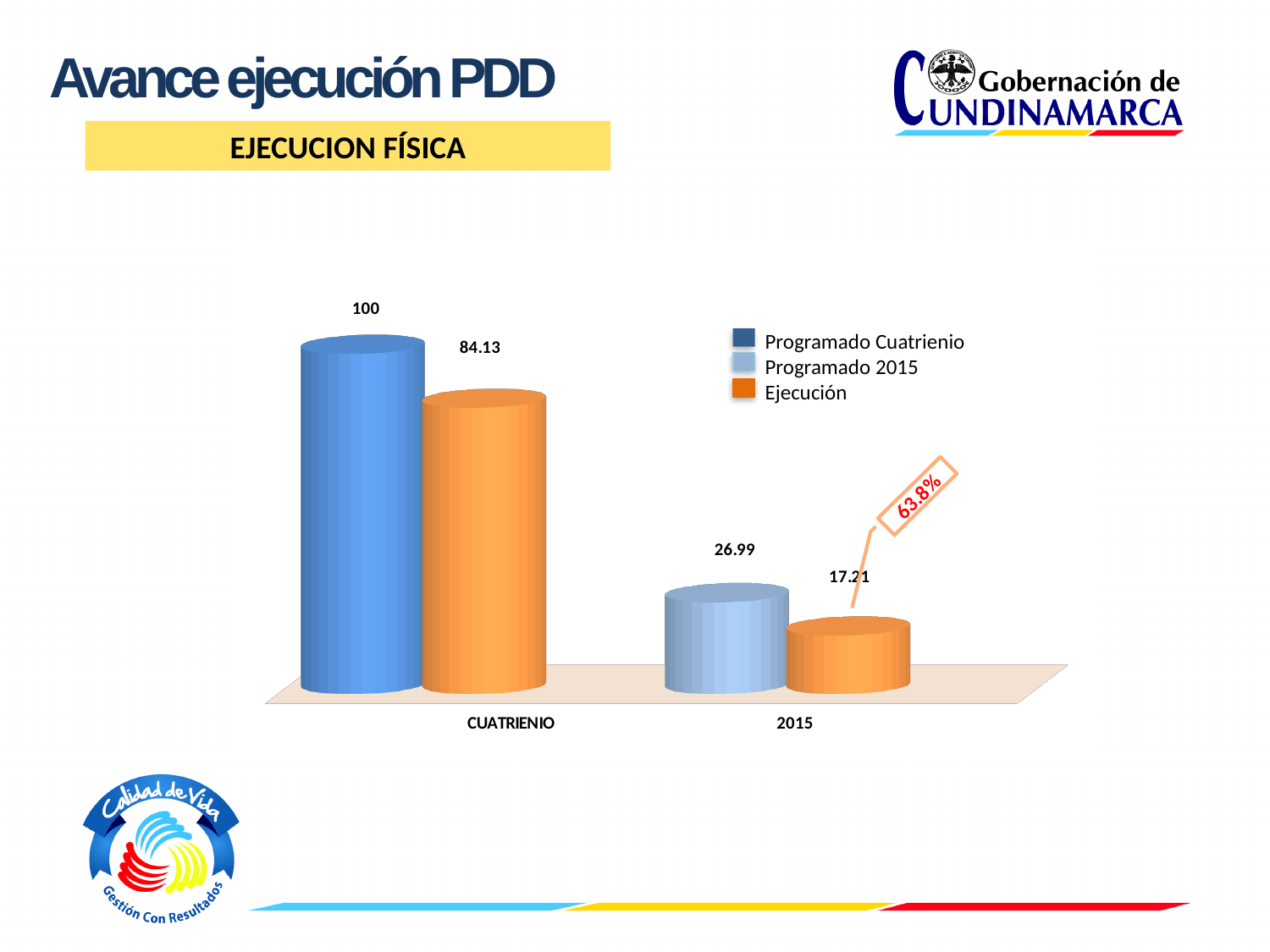
Which is larger for 2015: Programado 2015 or Ejecución? Programado 2015 Which bar has the lowest value in the chart? Ejecución for 2015 What is the Ejecución value for CUATRIENIO? 84.13 Which bar has the highest value in the chart? Programado Cuatrienio (CUATRIENIO) What is the difference between Programado Cuatrienio (100) and Ejecución (84.13) for CUATRIENIO? 15.87 What percentage is shown in the callout annotation pointing to the 2015 Ejecución bar? 63.8% What is the value of Programado Cuatrienio for CUATRIENIO? 100 How many categories are shown on the x axis? 2 What is the difference between Programado 2015 and Ejecución for 2015? 9.78 What is the Ejecución value for 2015? 17.21 What is the value of Programado 2015 for the 2015 category? 26.99 How many series does the legend list? 3